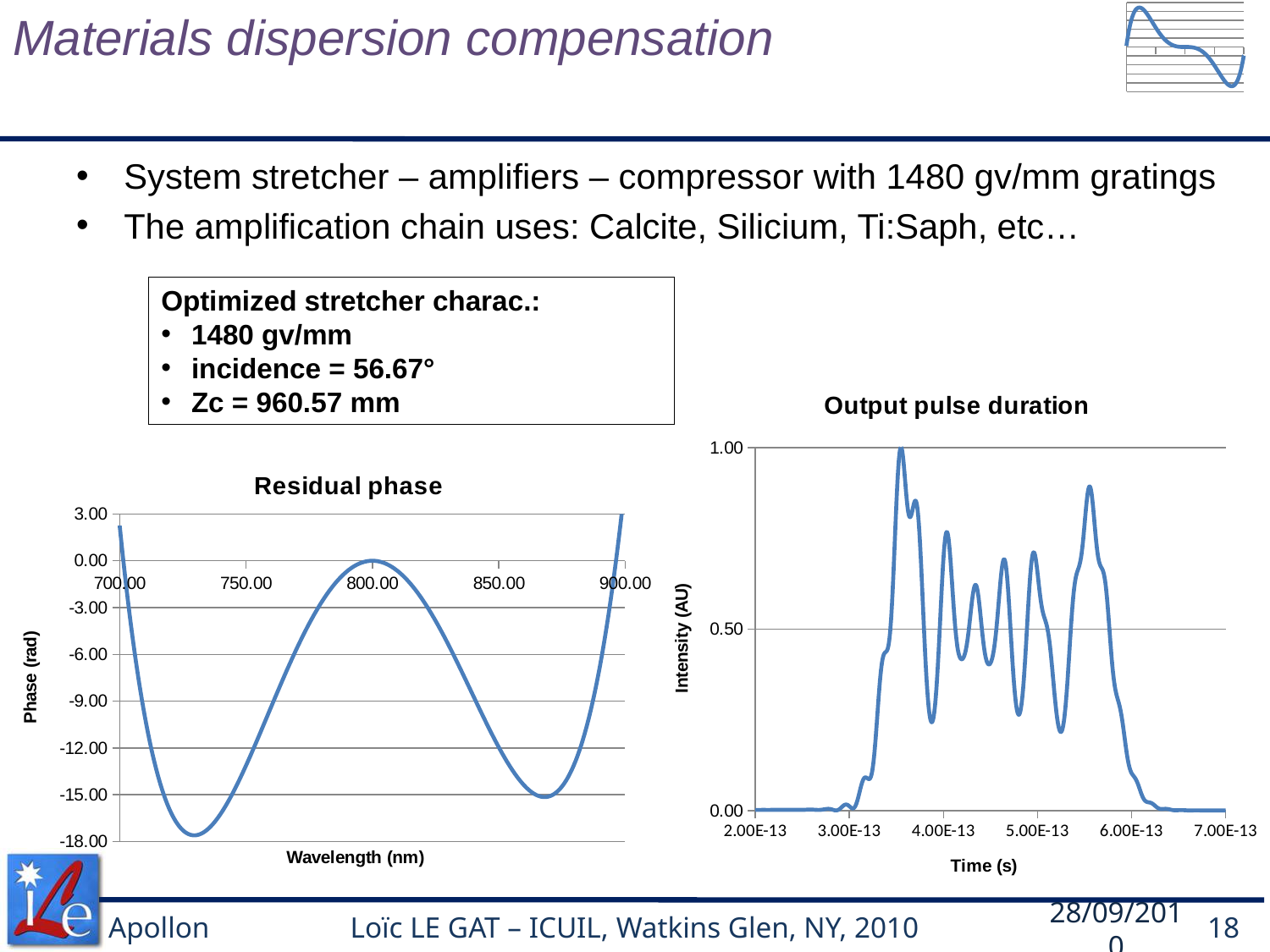
What is the x-axis label of the 'Residual phase' chart? Wavelength (nm) What kind of chart is the 'Residual phase' chart? line chart In the 'Output pulse duration' chart, is the intensity at 3.00E-13 s greater or less than 0.50? less In the 'Residual phase' chart, is the phase at 750.00 nm greater or less than -6.00? less In the 'Residual phase' chart, is the phase at 700.00 nm greater or less than 0.00? greater In the 'Residual phase' chart, does the phase rise or fall between 800.00 nm and 850.00 nm? fall In the 'Residual phase' chart, does the phase rise or fall between 750.00 nm and 800.00 nm? rise In the 'Output pulse duration' chart, what is the highest value shown on the intensity axis? 1.00 How many data series are plotted in the 'Output pulse duration' chart? 1 What kind of chart is the 'Output pulse duration' chart? line chart